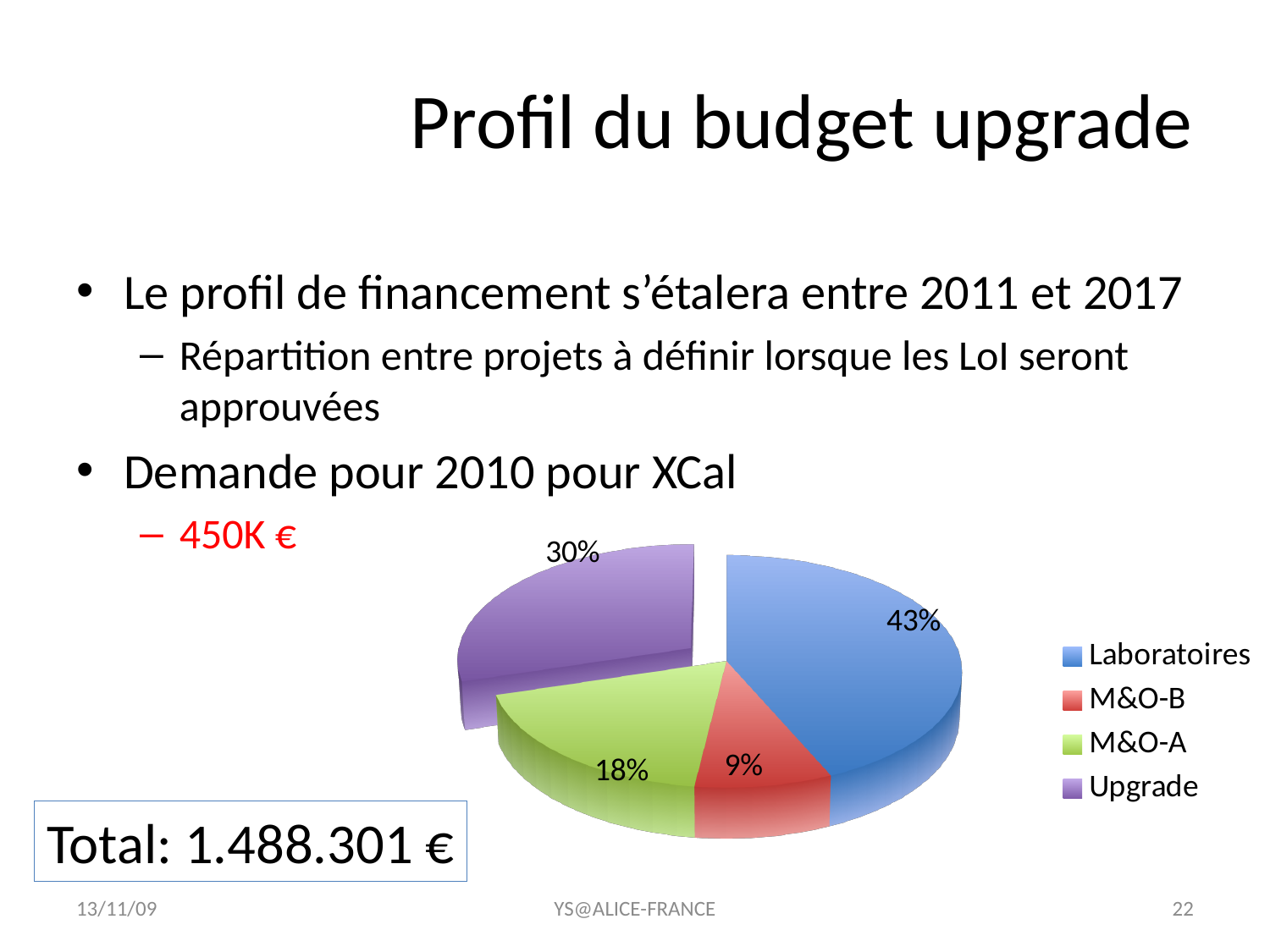
What kind of chart is shown on the slide? pie chart What share of the pie does M&O-B represent? 9% What share of the pie does M&O-A represent? 18% What colour is the Upgrade slice in the pie chart? purple What share of the pie does Laboratoires represent? 43% Which is larger, the M&O-A slice or the M&O-B slice? M&O-A Which category has the largest slice of the pie? Laboratoires How many entries does the legend list? 4 What share of the pie does Upgrade represent? 30% Which category has the smallest slice of the pie? M&O-B What is the difference in percentage points between the Laboratoires slice and the Upgrade slice? 13 How many slices does the pie chart have? 4